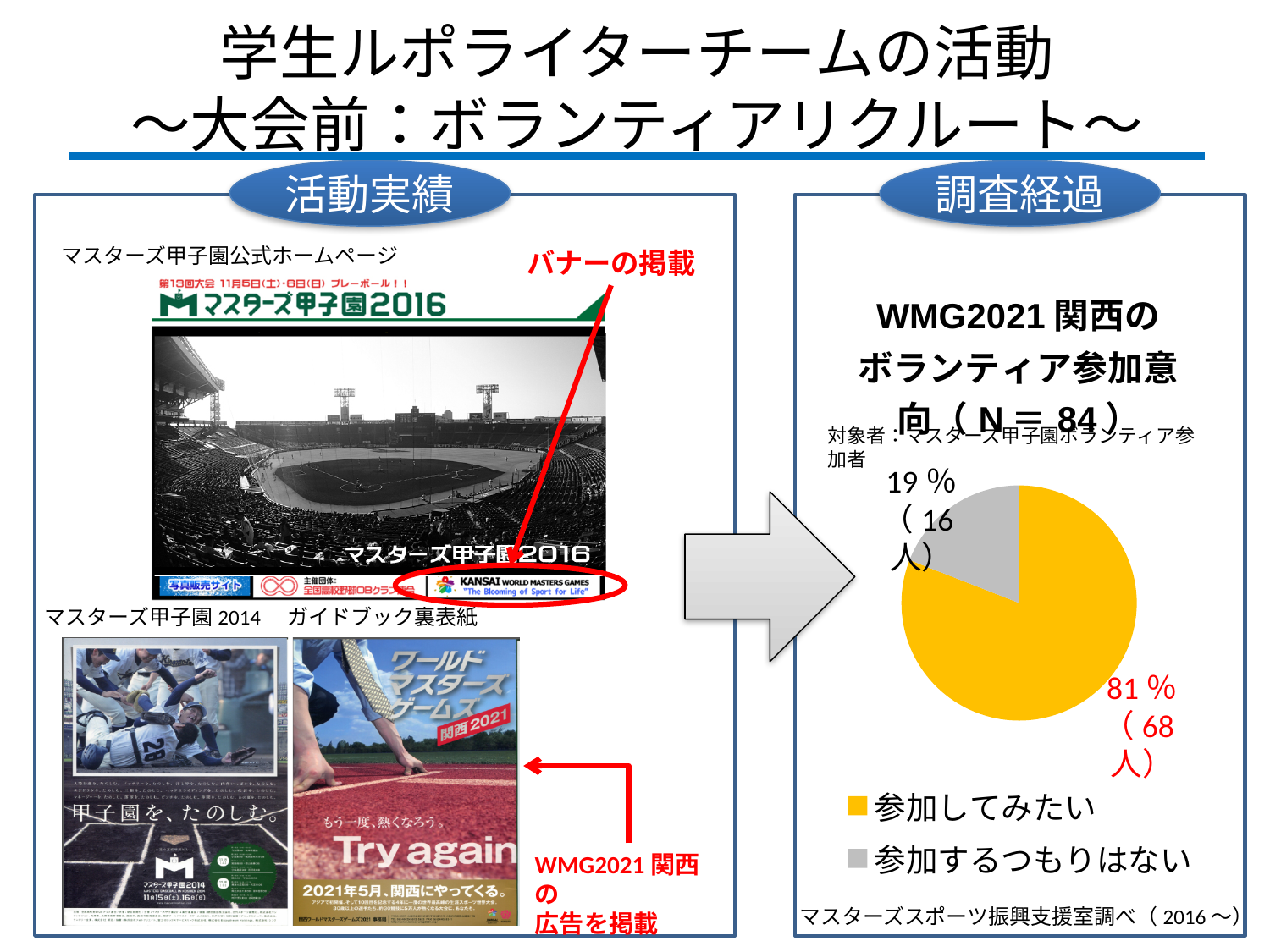
What percentage of respondents answered 参加してみたい? 81% How many categories does the pie chart have? 2 Which response has the smallest share of the pie? 参加するつもりはない What kind of chart is shown on the slide? pie chart How many people answered 参加するつもりはない? 16人 How many more people answered 参加してみたい than 参加するつもりはない? 52人 How many people answered 参加してみたい? 68人 What percentage of respondents answered 参加するつもりはない? 19% Which response has the largest share of the pie? 参加してみたい What is the total number of respondents (N) stated in the chart title? 84 What colour represents 参加してみたい in the pie chart? yellow By how many percentage points does 参加してみたい exceed 参加するつもりはない? 62 percentage points